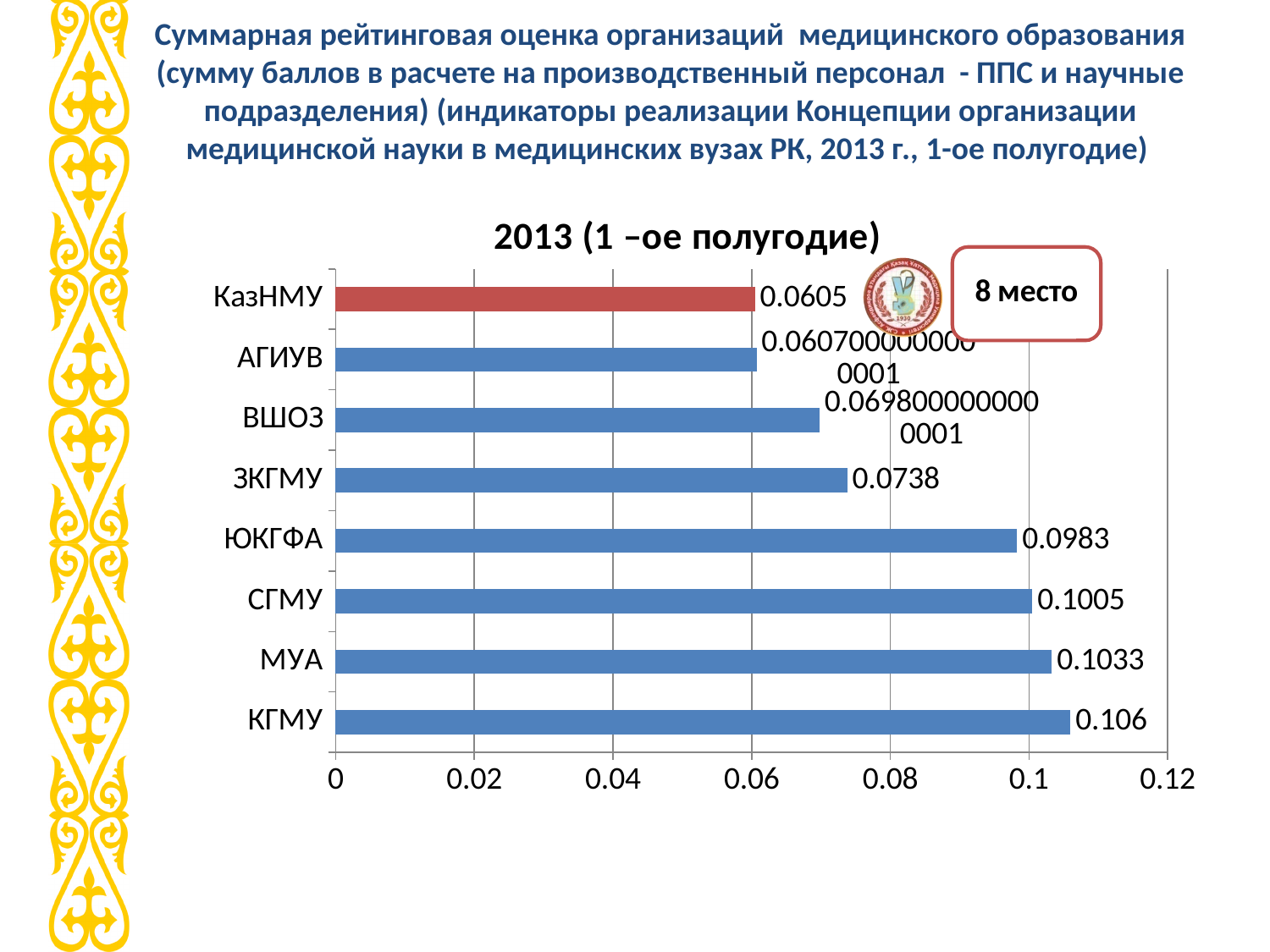
How many categories are shown in the chart? 8 What is the difference between the values for КГМУ and МУА? 0.0027 Which category has the highest value? КГМУ What kind of chart is shown on the slide? bar chart Which category has the lowest value? КазНМУ Which is larger, the value for СГМУ or the value for ЗКГМУ? СГМУ Is the value for ЮКГФА greater or less than 0.1? less What is the value for КазНМУ? 0.0605 Which category's bar is coloured red? КазНМУ What is the value for ЗКГМУ? 0.0738 What is the value for ЮКГФА? 0.0983 What is the value for КГМУ? 0.106